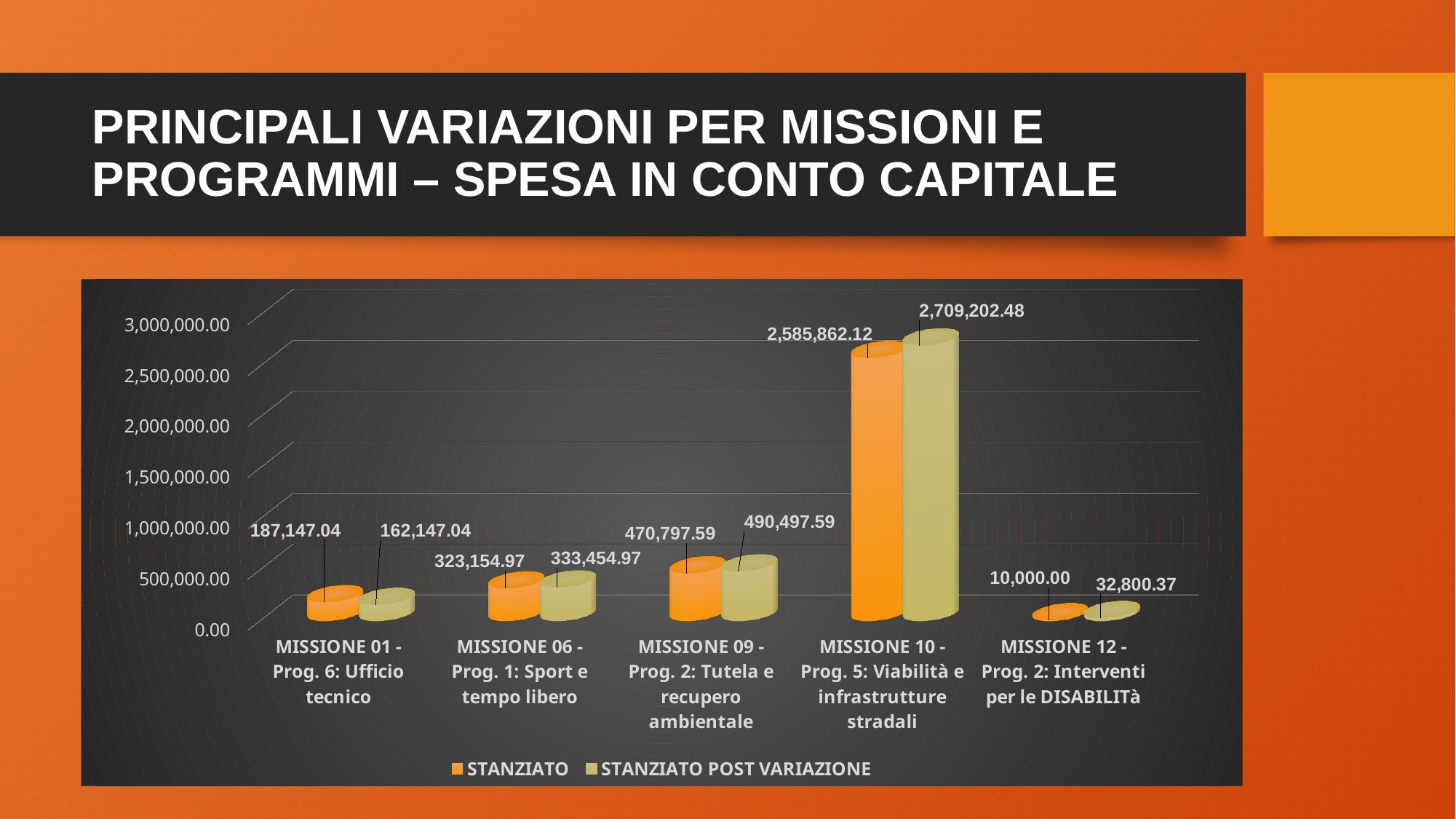
How many categories are shown on the x axis? 5 What is the difference between STANZIATO and STANZIATO POST VARIAZIONE for MISSIONE 01 - Prog. 6: Ufficio tecnico? 25,000.00 What is the STANZIATO value for MISSIONE 12 - Prog. 2: Interventi per le DISABILITà? 10,000.00 What is the difference between STANZIATO POST VARIAZIONE and STANZIATO for MISSIONE 10 - Prog. 5: Viabilità e infrastrutture stradali? 123,340.36 What is the STANZIATO POST VARIAZIONE value for MISSIONE 01 - Prog. 6: Ufficio tecnico? 162,147.04 What is the STANZIATO POST VARIAZIONE value for MISSIONE 09 - Prog. 2: Tutela e recupero ambientale? 490,497.59 Which category has the highest STANZIATO POST VARIAZIONE value? MISSIONE 10 - Prog. 5: Viabilità e infrastrutture stradali What is the STANZIATO value for MISSIONE 10 - Prog. 5: Viabilità e infrastrutture stradali? 2,585,862.12 Which category has the lowest STANZIATO value? MISSIONE 12 - Prog. 2: Interventi per le DISABILITà How many series does the legend list? 2 What kind of chart is shown on the slide? Bar chart For MISSIONE 06 - Prog. 1: Sport e tempo libero, which is larger: STANZIATO or STANZIATO POST VARIAZIONE? STANZIATO POST VARIAZIONE